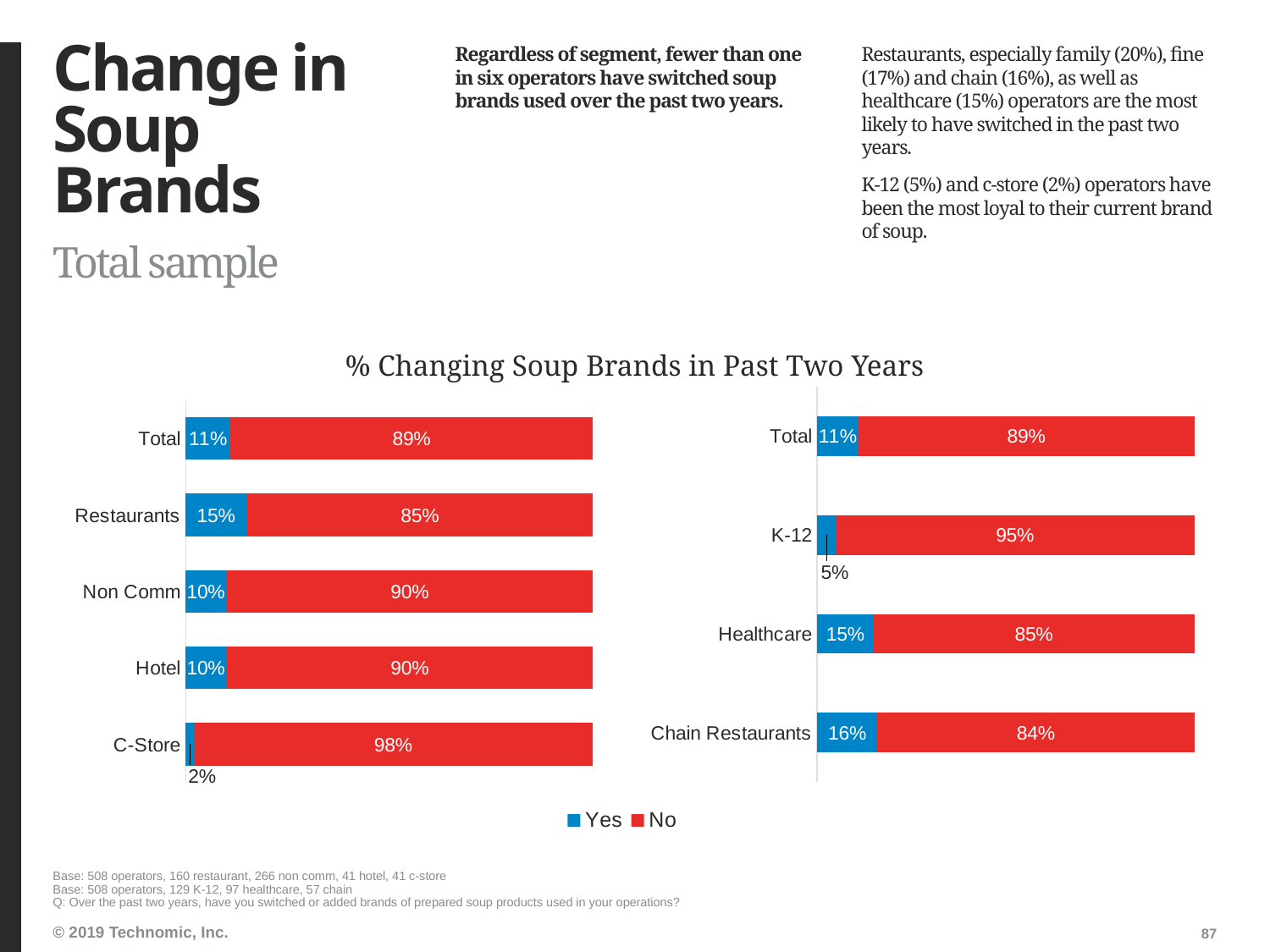
In the right chart, which is larger: the 'Yes' value for Healthcare or the 'Yes' value for K-12? Healthcare How many series does the legend list? 2 In the left chart, which category has the lowest 'Yes' value? C-Store How many categories are shown in the left chart? 5 In the left chart, what is the difference between the 'No' values for C-Store and Total? 9% In the right chart, which category has the highest 'Yes' value? Chain Restaurants In the right chart, what is the total of the stacked bar for Healthcare? 100% What type of chart is the right chart? Stacked bar chart In the left chart, what is the 'Yes' value for Restaurants? 15% In the right chart, what is the 'Yes' value for K-12? 5% In the right chart, what is the 'No' value for Chain Restaurants? 84% In the left chart, what is the 'No' value for C-Store? 98%